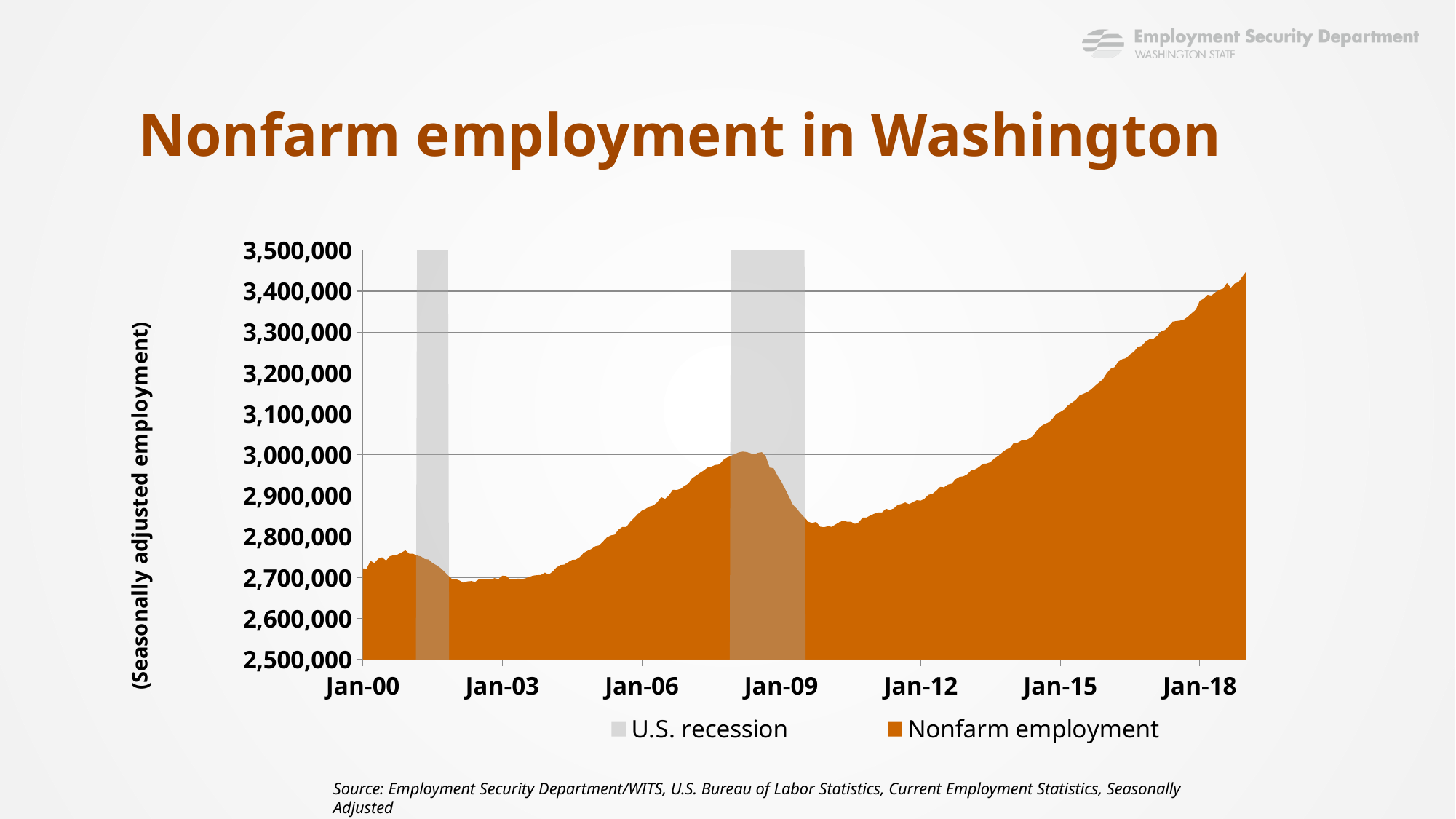
Is the value for nonfarm employment at Jan-15 greater or less than 3,000,000? greater What is the title of the chart on the slide? Nonfarm employment in Washington How many entries does the chart legend list? 2 Is the lowest point of the nonfarm employment series closer to Jan-03 or to Jan-09? Jan-03 Is the value for nonfarm employment at Jan-03 greater or less than 2,800,000? less Which is larger, nonfarm employment at Jan-06 or at Jan-15? Jan-15 How many shaded U.S. recession periods are shown on the chart? 2 What does the y-axis label say? (Seasonally adjusted employment) What kind of chart is shown on the slide? Area chart Is the value for nonfarm employment at Jan-18 greater or less than 3,300,000? greater Overall, does nonfarm employment rise or fall from Jan-00 to the end of the series? Rise How many date labels are printed on the x-axis? 7